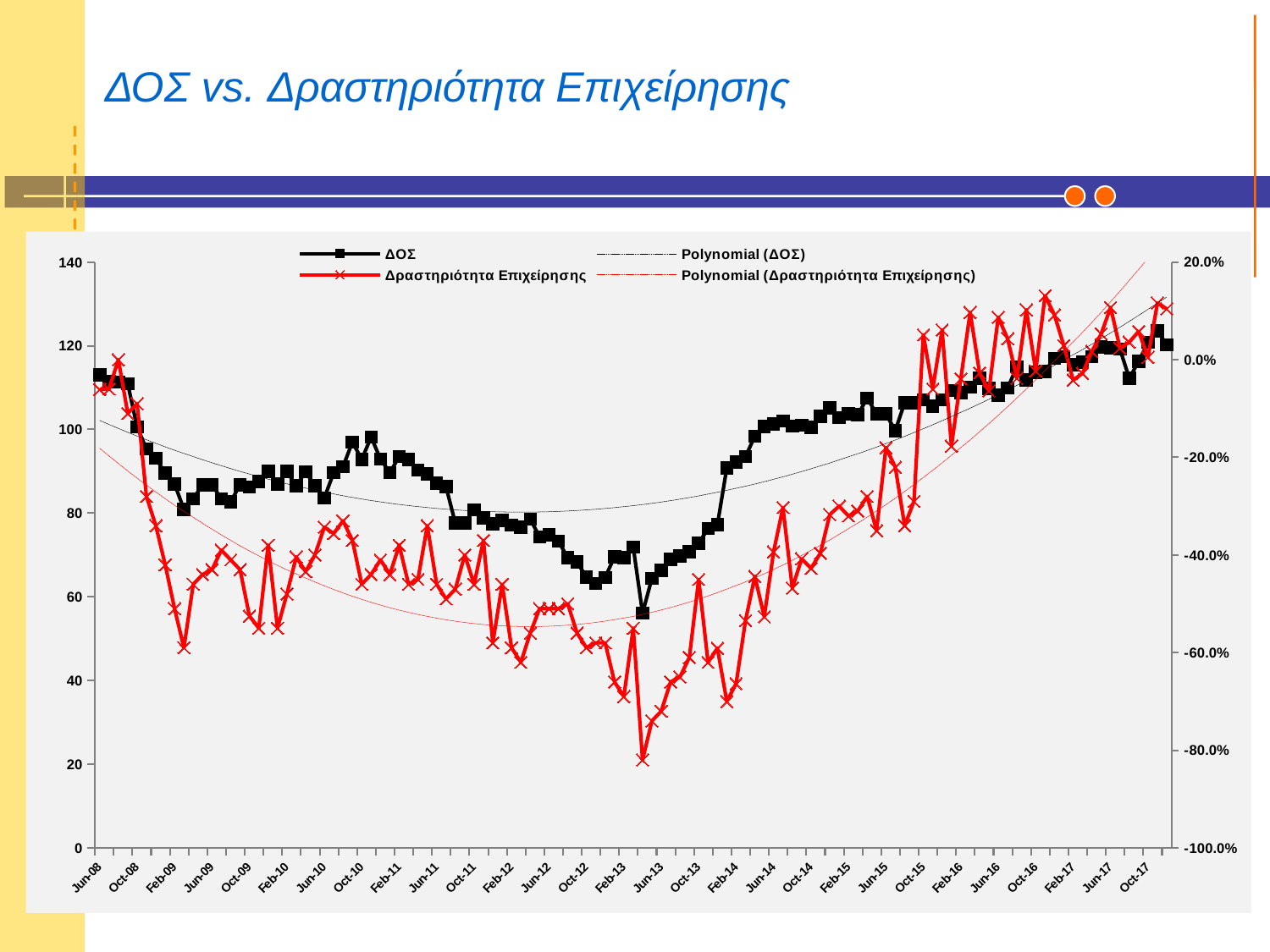
How many entries does the chart legend list? 4 Around which date does the ΔΟΣ series reach its lowest point? Apr-13 Is the Δραστηριότητα Επιχείρησης value at Feb-09 greater or less than -40.0%? less What colour is the ΔΟΣ line in the chart? Black Is the Δραστηριότητα Επιχείρησης value at Jun-13 greater or less than -60.0%? less Is the ΔΟΣ value at Jun-08 greater or less than 100? greater What is the title of the slide containing the chart? ΔΟΣ vs. Δραστηριότητα Επιχείρησης What kind of chart is shown on the slide? Line chart Around which date does the Δραστηριότητα Επιχείρησης series reach its lowest point? Apr-13 Does the ΔΟΣ series generally rise or fall between Jun-13 and Oct-17? Rise